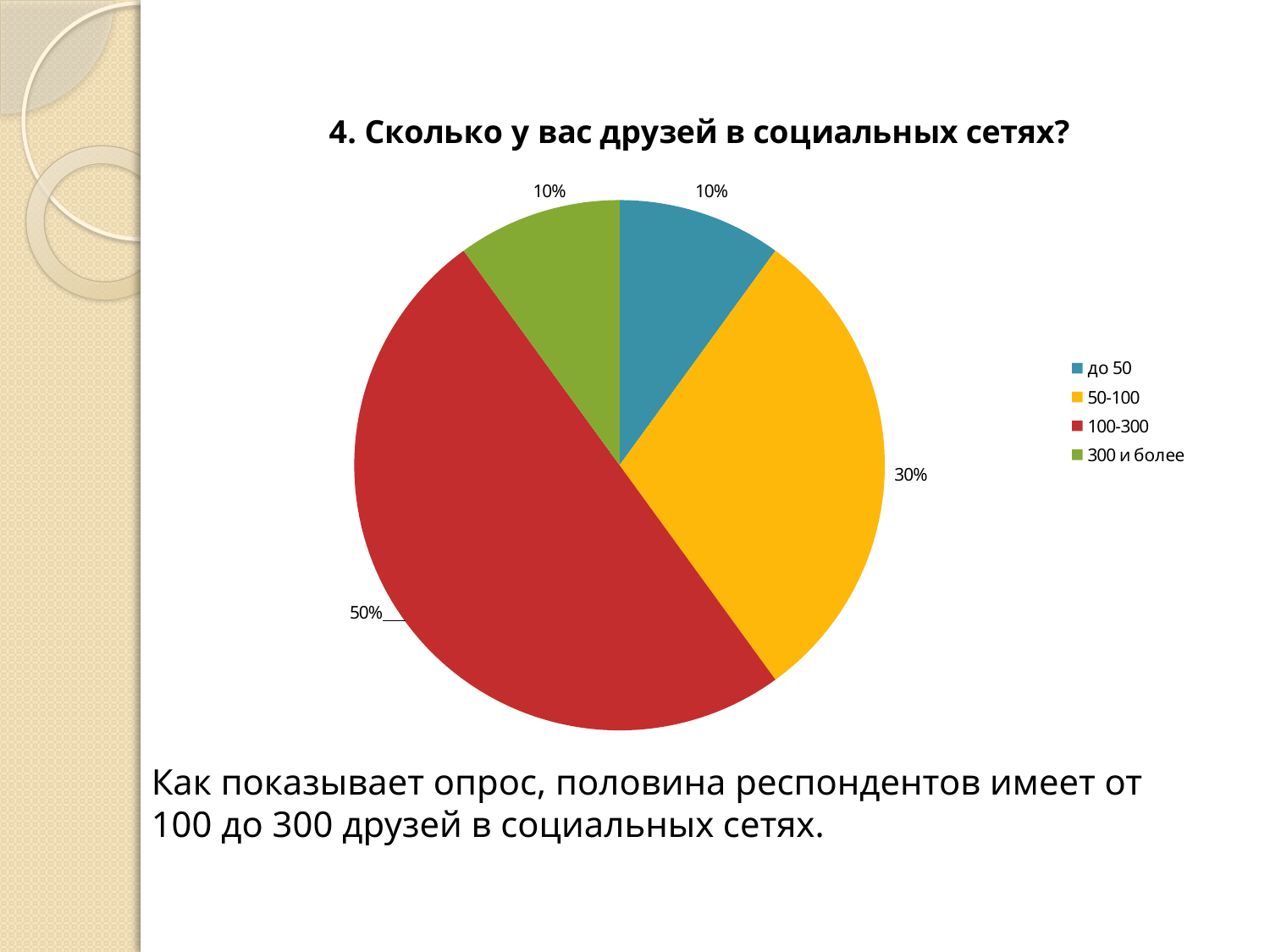
What share of the pie is the "100-300" slice? 50% What kind of chart is shown on the slide? pie chart Which is larger, the "50-100" slice or the "300 и более" slice? 50-100 What share of the pie is the "300 и более" slice? 10% What share of the pie is the "до 50" slice? 10% How many categories does the legend list? 4 What is the title of the chart? 4. Сколько у вас друзей в социальных сетях? Is the share for "50-100" greater or less than 50%? less Which category has the largest slice? 100-300 What is the difference between the "100-300" share and the "50-100" share? 20% What colour is the "100-300" slice? red